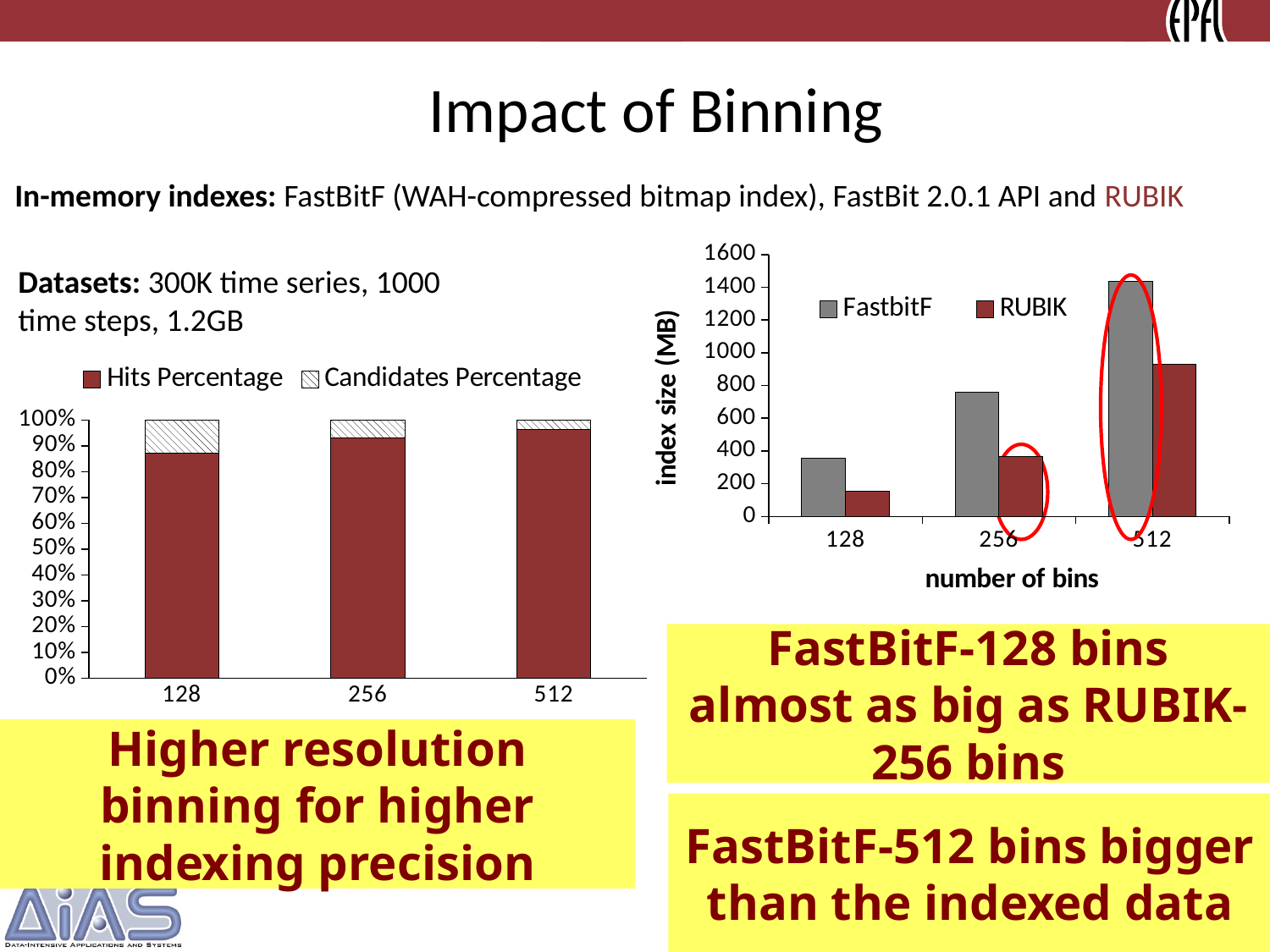
On the left chart (Hits Percentage / Candidates Percentage), how many categories are shown on the x axis? 3 On the right chart (index size vs number of bins), what is the label of the vertical axis? index size (MB) On the right chart (index size vs number of bins), at 256 bins, which series has the larger index size, FastbitF or RUBIK? FastbitF On the left chart (Hits Percentage / Candidates Percentage), is the Hits Percentage at 128 bins greater or less than 90%? less On the left chart (Hits Percentage / Candidates Percentage), how does the Hits Percentage change as the number of bins increases from 128 to 512? It rises On the right chart (index size vs number of bins), which bar is the highest? FastbitF at 512 bins On the right chart (index size vs number of bins), is the FastbitF value at 512 bins greater or less than 1200? greater On the right chart (index size vs number of bins), is the RUBIK value at 128 bins greater or less than 200? less On the right chart (index size vs number of bins), how does the RUBIK index size change as the number of bins increases? It rises On the right chart (index size vs number of bins), how many series does the legend list? 2 On the right chart (index size vs number of bins), which bar is the lowest? RUBIK at 128 bins